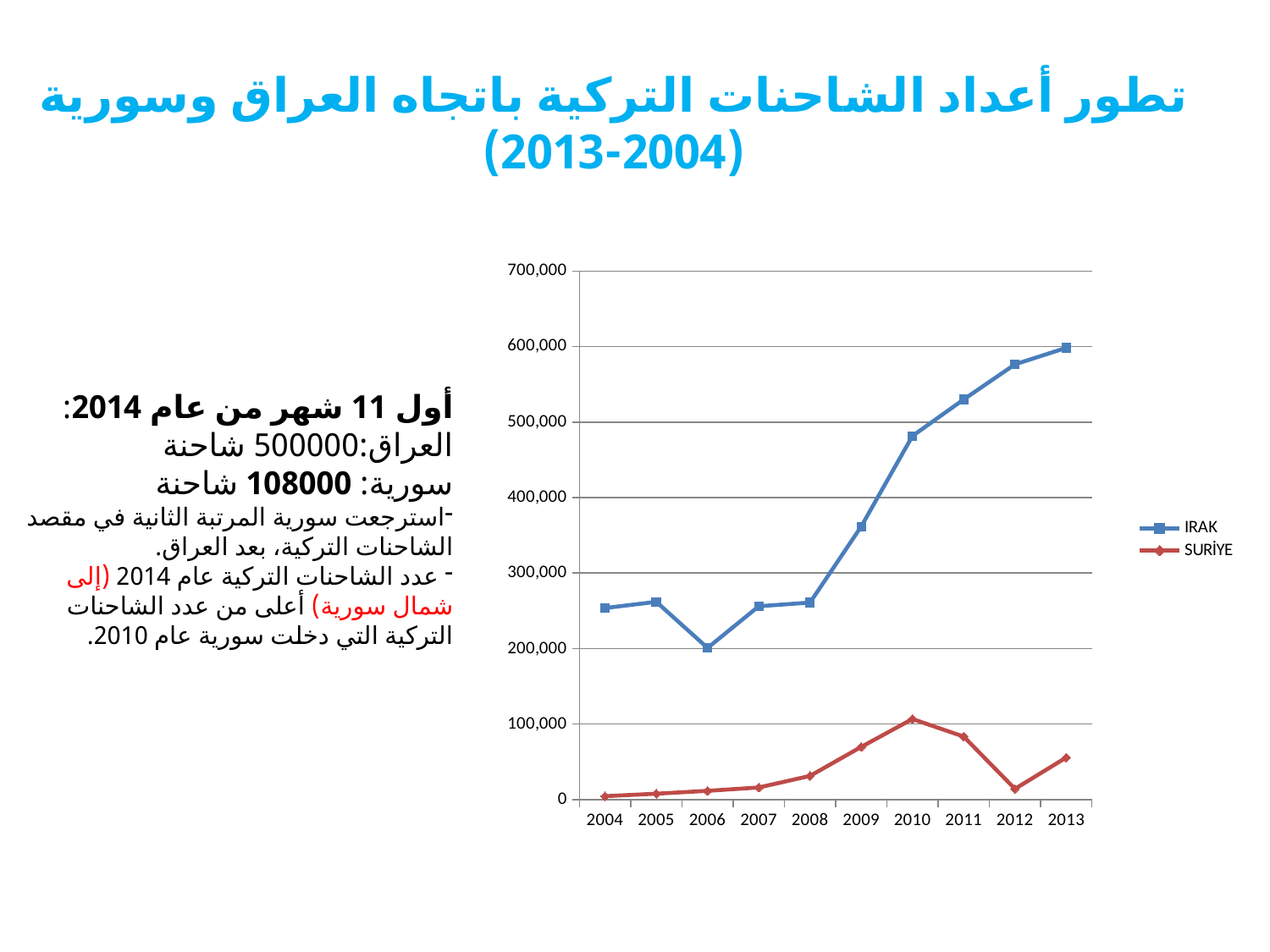
In which year does the SURİYE series reach its highest value? 2010 Which is larger for the SURİYE series: the value in 2010 or the value in 2012? 2010 Is the IRAK value for 2006 greater or less than 300,000? less How many series does the chart legend list? 2 Does the IRAK series rise or fall from 2008 to 2013? rise In which year does the IRAK series reach its highest value? 2013 In which year does the IRAK series reach its lowest value? 2006 What are the two series named in the legend? IRAK and SURİYE What kind of chart is shown on the slide? line chart How many years are plotted along the x axis? 10 Is the SURİYE value for 2011 greater or less than 100,000? less Is the IRAK value for 2010 greater or less than 400,000? greater